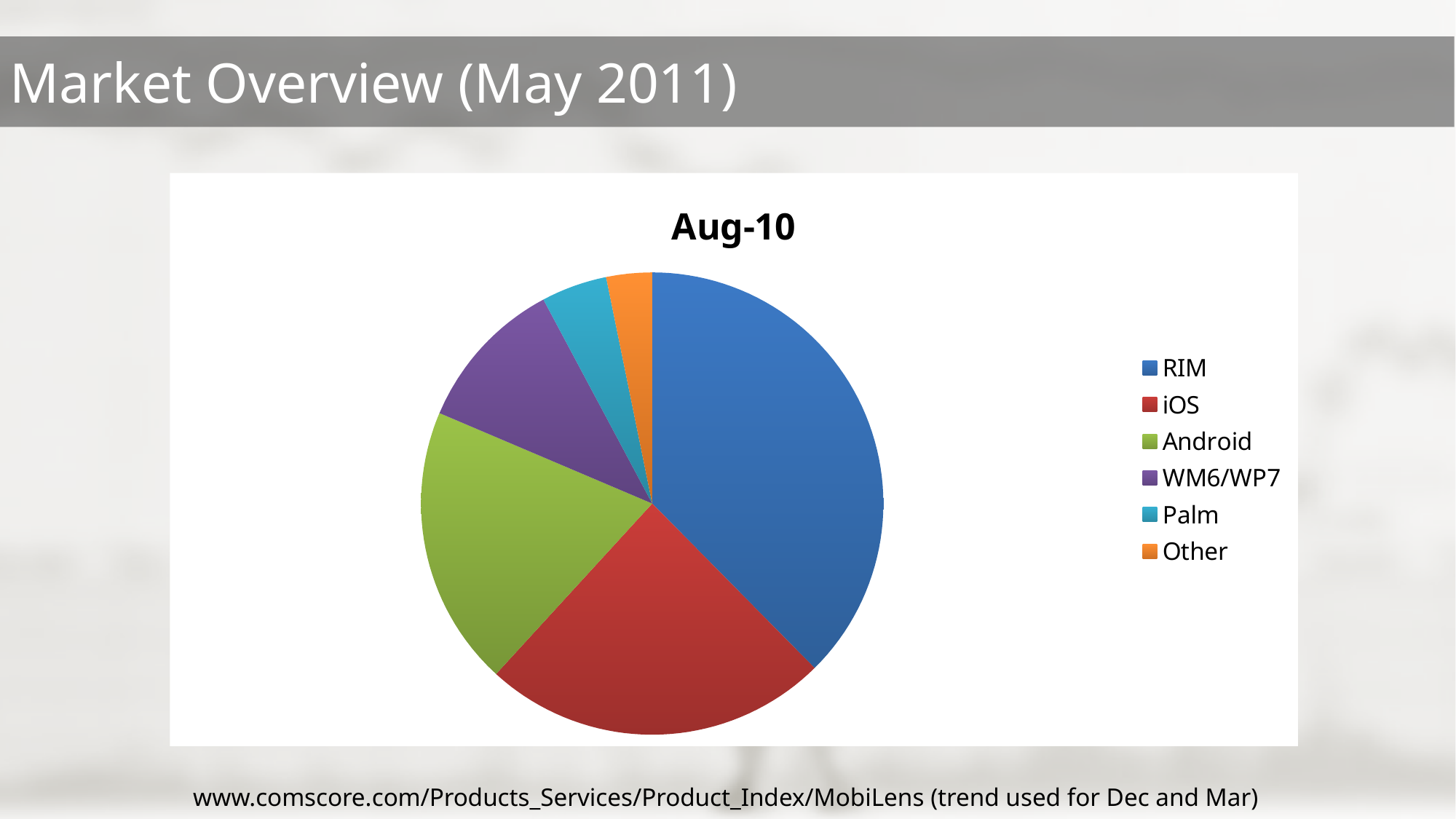
Which category is shown in blue in the pie chart? RIM Which slice is larger, Android or WM6/WP7? Android Which slice is larger, WM6/WP7 or Other? WM6/WP7 What kind of chart is shown on the slide? pie chart Which category has the smallest slice of the pie? Other How many entries does the legend list? 6 How many categories does the pie chart show? 6 Which slice is larger, RIM or Android? RIM What is the title of the chart? Aug-10 Which category has the largest slice of the pie? RIM